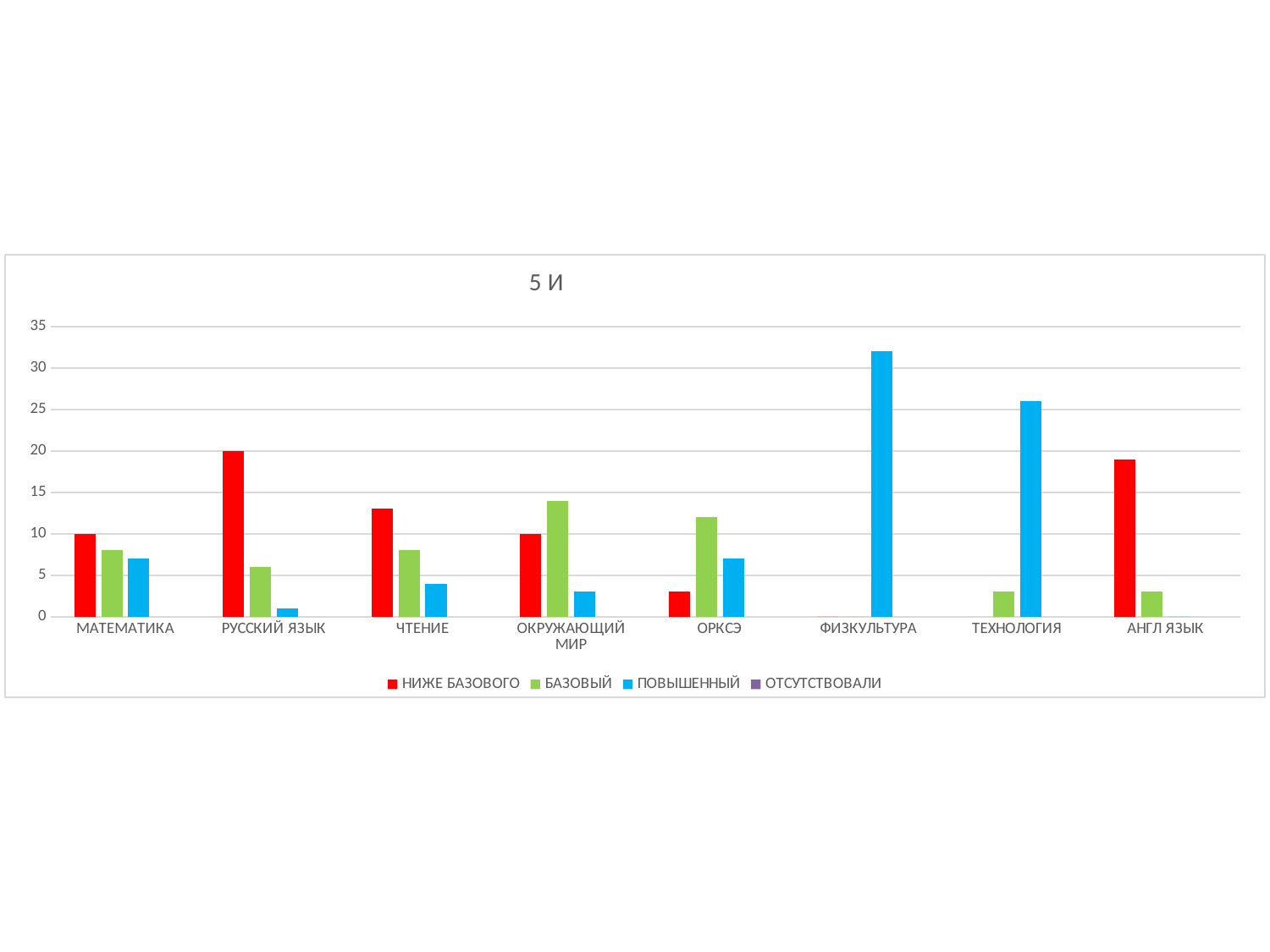
What is the value of НИЖЕ БАЗОВОГО for МАТЕМАТИКА? 10 Is the ПОВЫШЕННЫЙ value for ФИЗКУЛЬТУРА greater or less than 30? greater What is the title of the chart? 5 И What is the value of НИЖЕ БАЗОВОГО for РУССКИЙ ЯЗЫК? 20 How many series does the legend list? 4 Which subject has the highest НИЖЕ БАЗОВОГО value? РУССКИЙ ЯЗЫК What kind of chart is shown on the slide? bar chart Which is larger for ОРКСЭ: БАЗОВЫЙ or НИЖЕ БАЗОВОГО? БАЗОВЫЙ Is the ПОВЫШЕННЫЙ value for ТЕХНОЛОГИЯ greater or less than 25? greater What is the value of НИЖЕ БАЗОВОГО for ОКРУЖАЮЩИЙ МИР? 10 Which subject has the highest ПОВЫШЕННЫЙ value? ФИЗКУЛЬТУРА How many subject categories are shown on the x axis? 8